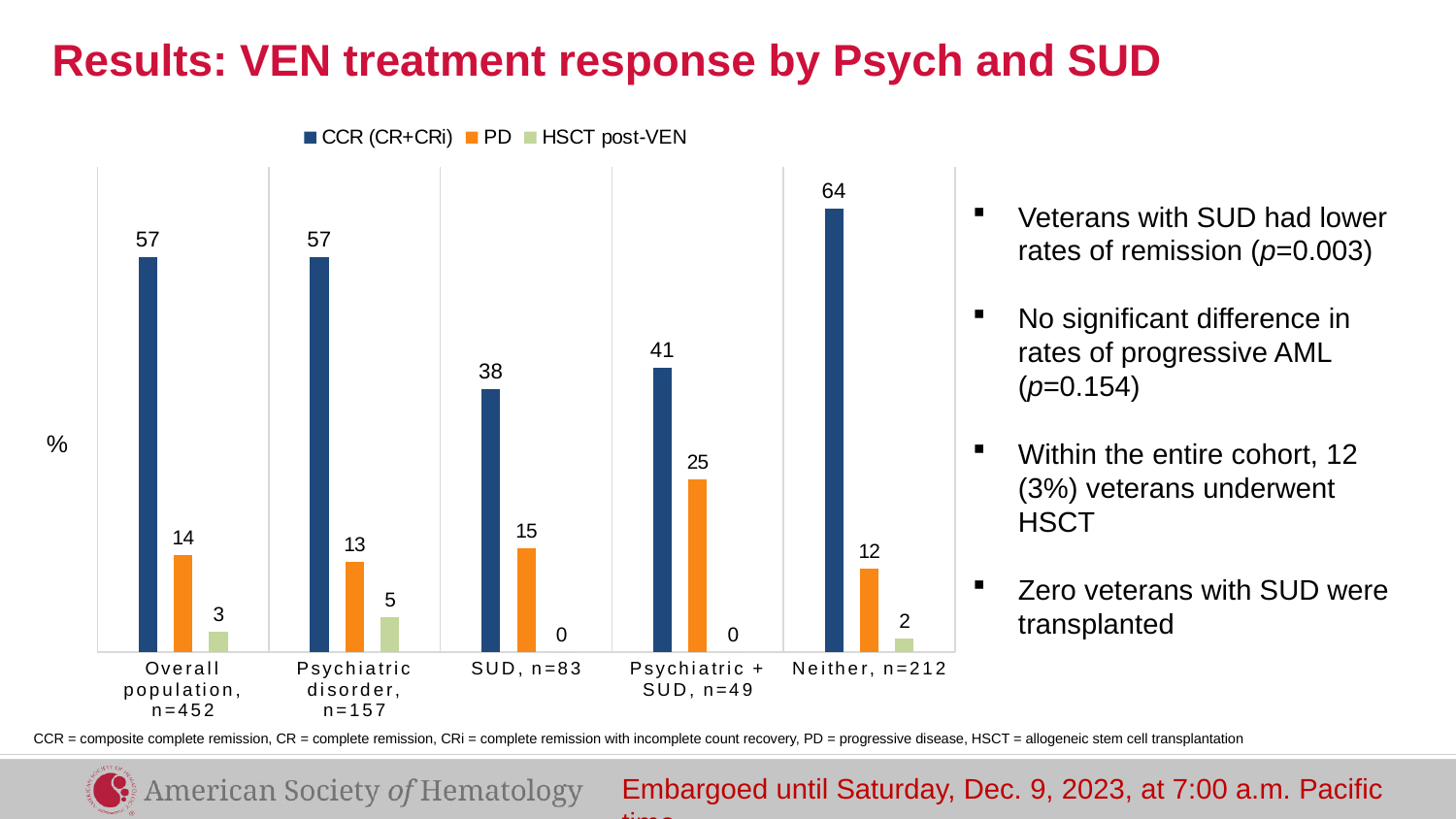
What is the HSCT post-VEN value for Psychiatric disorder, n=157? 5 What kind of chart is shown on the slide? Bar chart What is the CCR (CR+CRi) value for the Overall population, n=452? 57 Which category has the highest CCR (CR+CRi) value? Neither, n=212 How many categories are shown on the x axis? 5 Which series is shown in orange in the legend? PD Which is larger, the PD value for Psychiatric disorder, n=157 or the PD value for SUD, n=83? SUD, n=83 Which category has the lowest CCR (CR+CRi) value? SUD, n=83 What is the difference between the CCR (CR+CRi) values for Neither, n=212 and SUD, n=83? 26 What is the HSCT post-VEN value for SUD, n=83? 0 What is the PD value for Psychiatric + SUD, n=49? 25 How many series does the legend list? 3